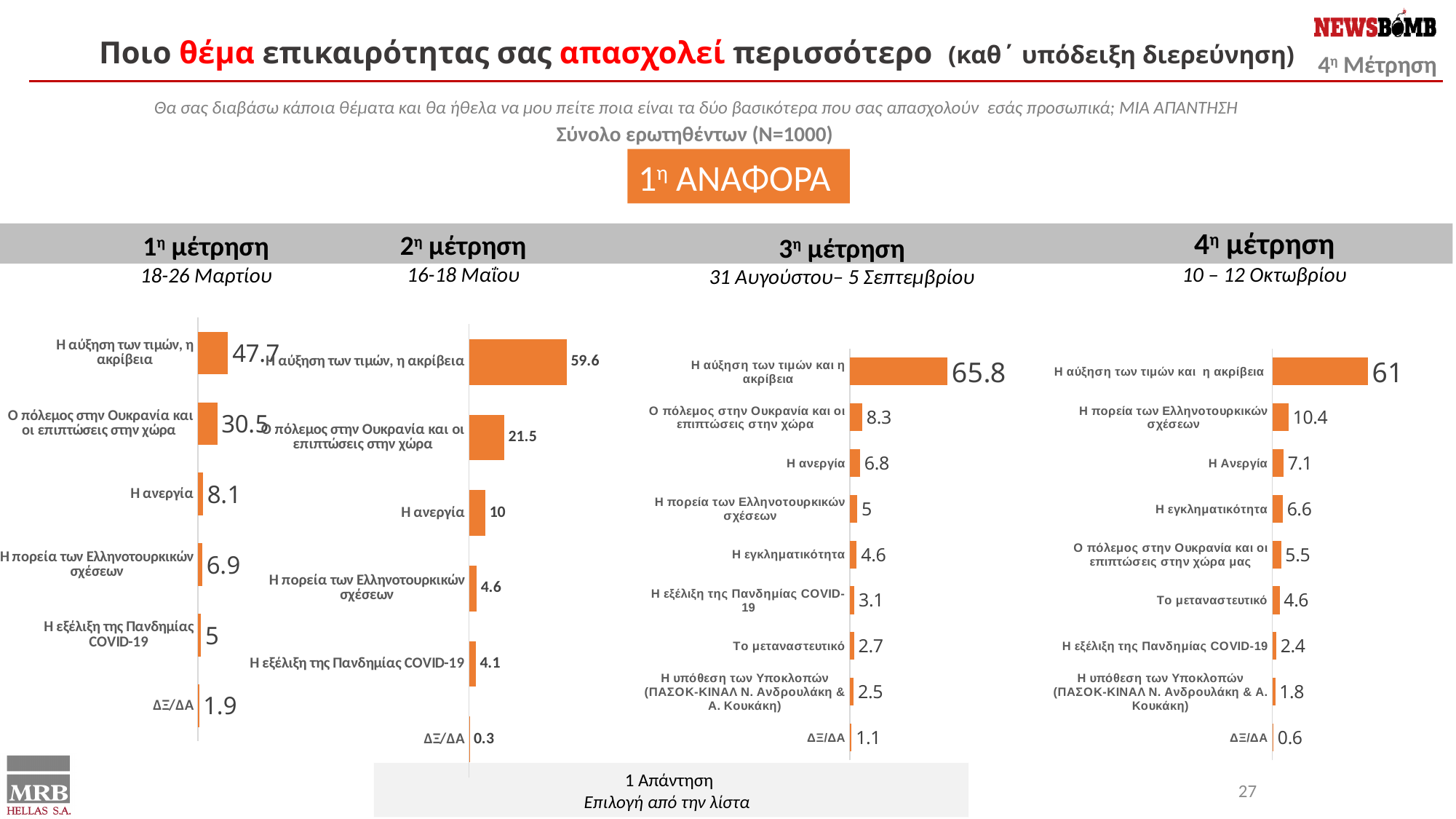
In the 3η μέτρηση chart, which category has the highest value? Η αύξηση των τιμών και η ακρίβεια In the 2η μέτρηση chart, what is the value for Ο πόλεμος στην Ουκρανία και οι επιπτώσεις στην χώρα? 21.5 In the 4η μέτρηση chart, what is the value for Η πορεία των Ελληνοτουρκικών σχέσεων? 10.4 In the 4η μέτρηση chart, which is larger: Η Ανεργία or Η εγκληματικότητα? Η Ανεργία In the 1η μέτρηση chart, what is the difference between Η αύξηση των τιμών, η ακρίβεια and Ο πόλεμος στην Ουκρανία και οι επιπτώσεις στην χώρα? 17.2 How many categories are shown in the 2η μέτρηση chart? 6 How many categories are shown in the 3η μέτρηση chart? 9 In the 4η μέτρηση chart, which category has the lowest value? ΔΞ/ΔΑ In the 3η μέτρηση chart, what is the value for Η ανεργία? 6.8 In the 1η μέτρηση chart, what is the value for Η αύξηση των τιμών, η ακρίβεια? 47.7 What kind of chart is the 2η μέτρηση chart? Bar chart What date range is shown under the 3η μέτρηση chart? 31 Αυγούστου– 5 Σεπτεμβρίου